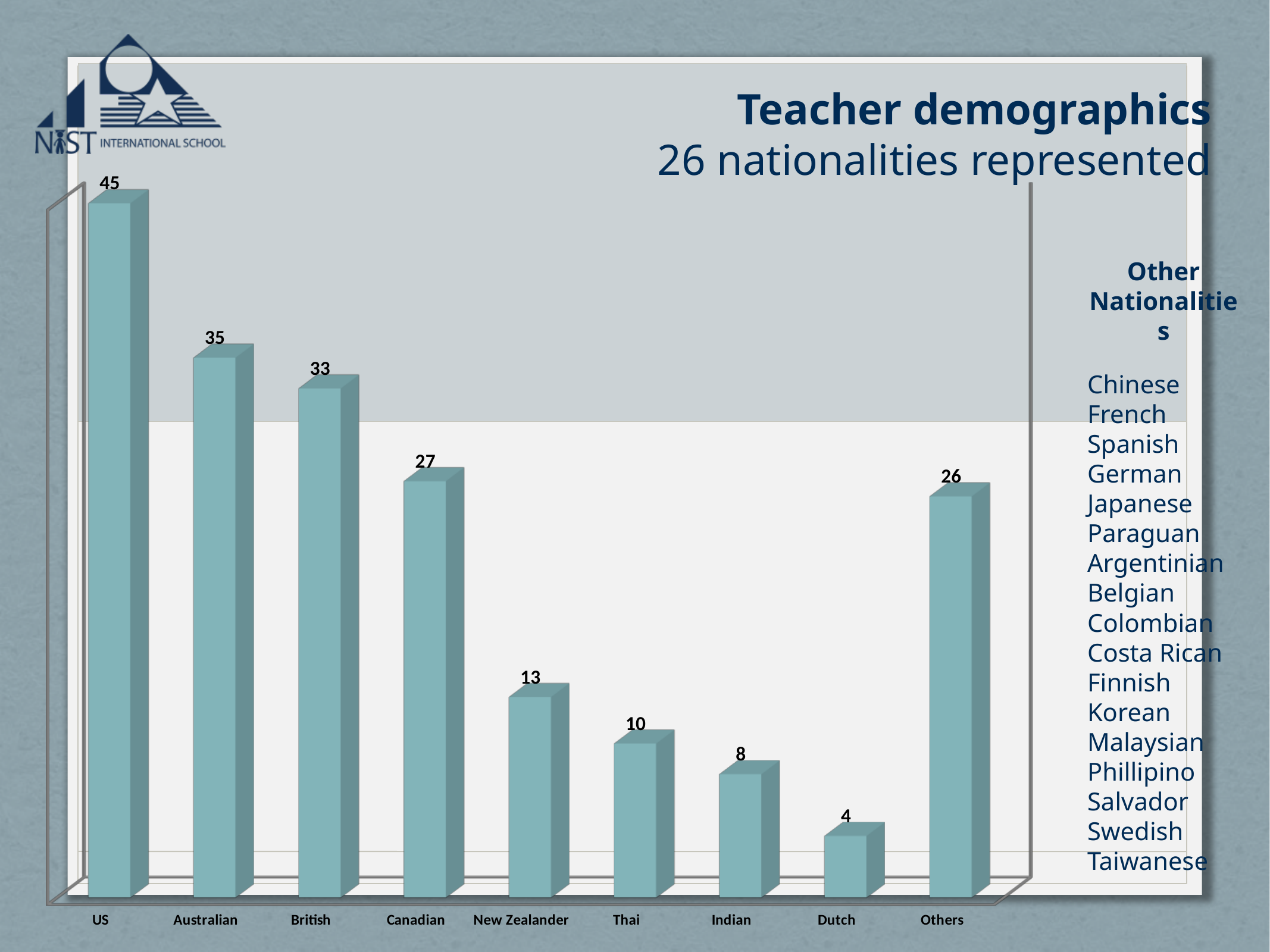
What is the difference between the values for US and Australian? 10 What is the difference between the values for Thai and Indian? 2 What kind of chart is shown on the slide? bar chart What is the value for Canadian? 27 Which category has the lowest value? Dutch What is the value for Others? 26 What is the title of the slide? Teacher demographics 26 nationalities represented Which is larger, the value for British or the value for Canadian? British How many categories are shown on the x axis? 9 What is the value for Dutch? 4 What is the value for US? 45 Which category has the highest value? US